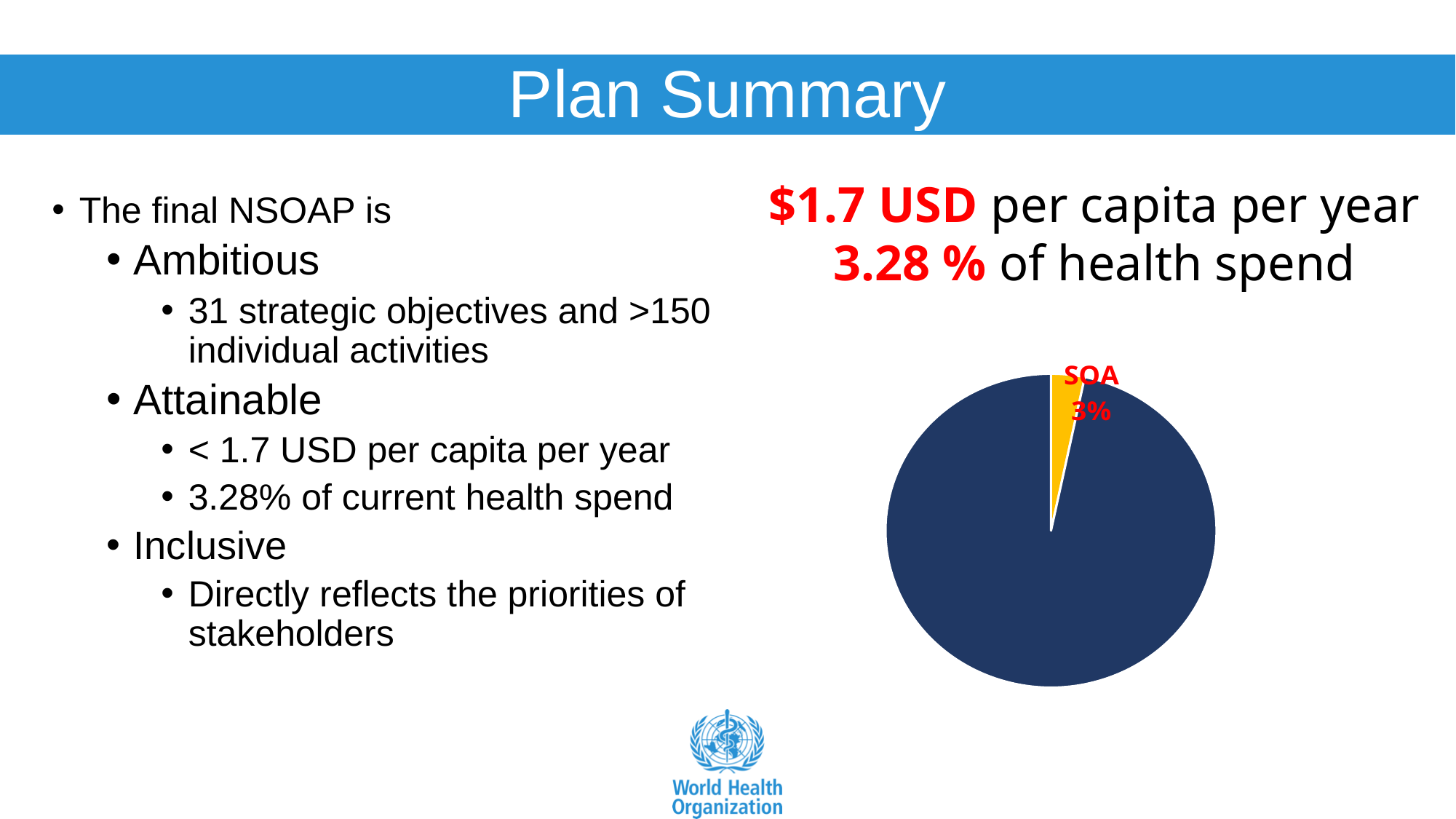
What share of the pie does the SOA slice represent? 3% Is the SOA slice the largest or the smallest slice of the pie chart? smallest How many slices does the pie chart have? 2 Which slice of the pie chart is larger, the SOA slice or the dark blue slice? the dark blue slice What colour is the SOA slice in the pie chart? yellow What percentage is shown for the SOA slice of the pie chart? 3% What kind of chart is shown on the right side of the slide? pie chart Which slice of the pie chart is labelled with a name and percentage? SOA